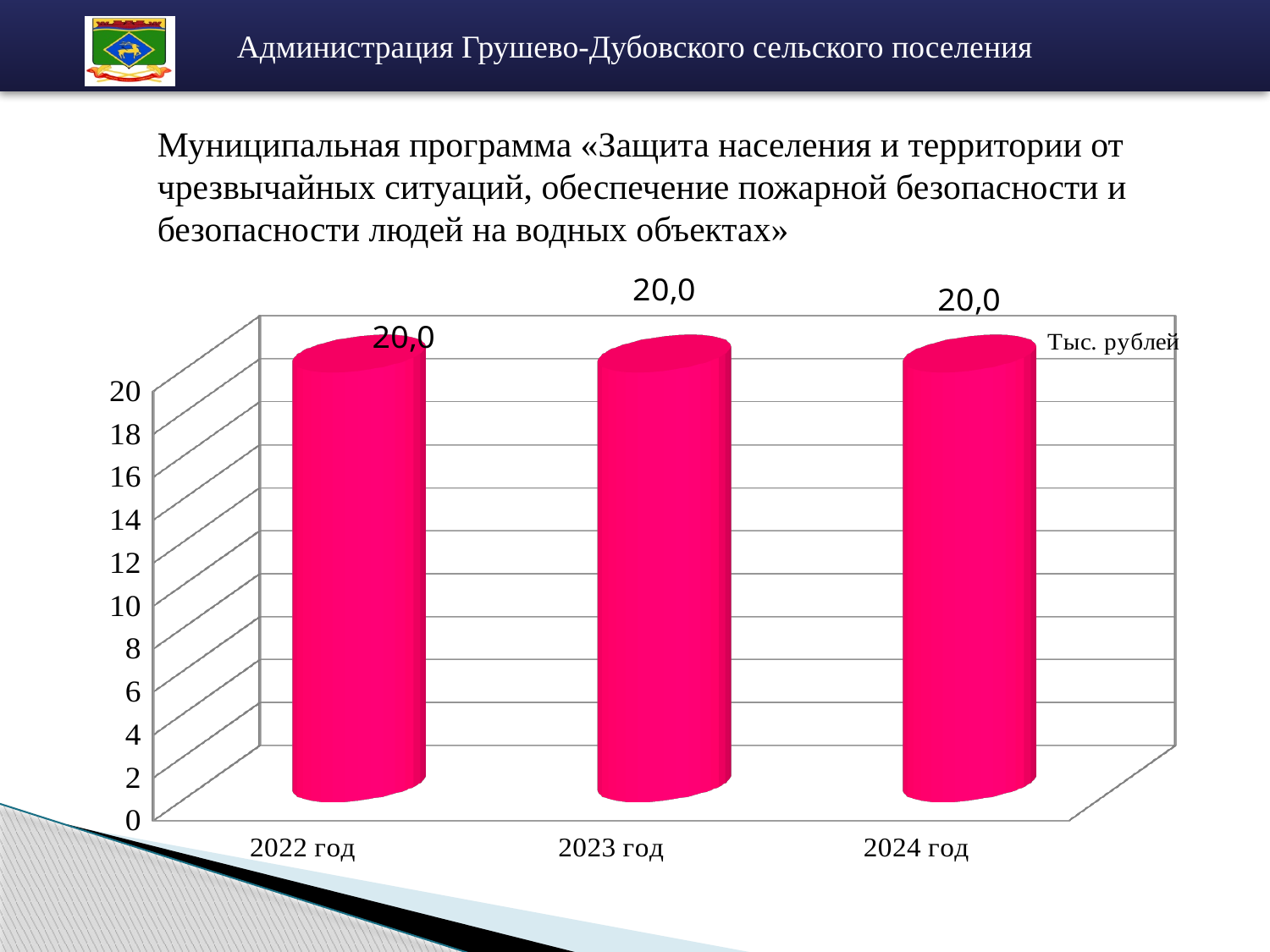
What colour are the bars in the chart? pink Do the values rise, fall or stay the same from 2022 год to 2024 год? stay the same Is the value for 2024 год greater or less than 10? greater What unit is indicated for the values on the chart? Тыс. рублей What kind of chart is shown on the slide? bar chart How many categories are shown on the x axis? 3 What is the highest tick value shown on the vertical axis? 20 What is the value for 2024 год? 20,0 What is the value for 2022 год? 20,0 What is the value for 2023 год? 20,0 What is the difference between the values for 2023 год and 2022 год? 0,0